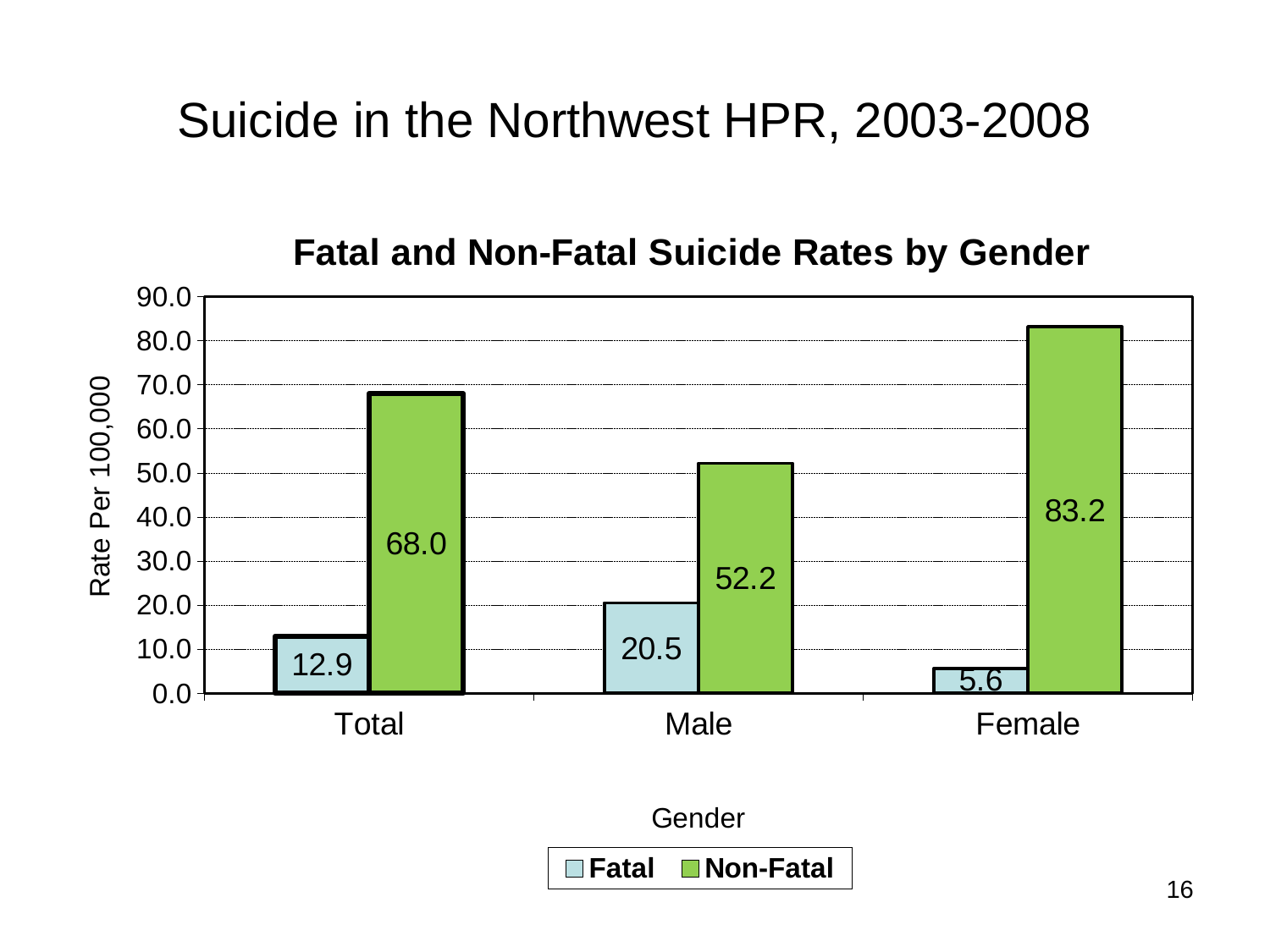
How many series does the legend list? 2 What is the Fatal suicide rate for Total? 12.9 Which is larger, the Fatal rate for Male or the Fatal rate for Female? Male What is the difference between the Non-Fatal rates for Female and Total? 15.2 What type of chart is shown on the slide? Bar chart Which gender category has the highest Non-Fatal rate? Female How many gender categories are shown on the x axis? 3 What is the Fatal suicide rate for Male? 20.5 Which gender category has the lowest Fatal rate? Female What is the Non-Fatal suicide rate for Male? 52.2 What is the Non-Fatal suicide rate for Female? 83.2 What is the difference between the Non-Fatal and Fatal rates for Male? 31.7